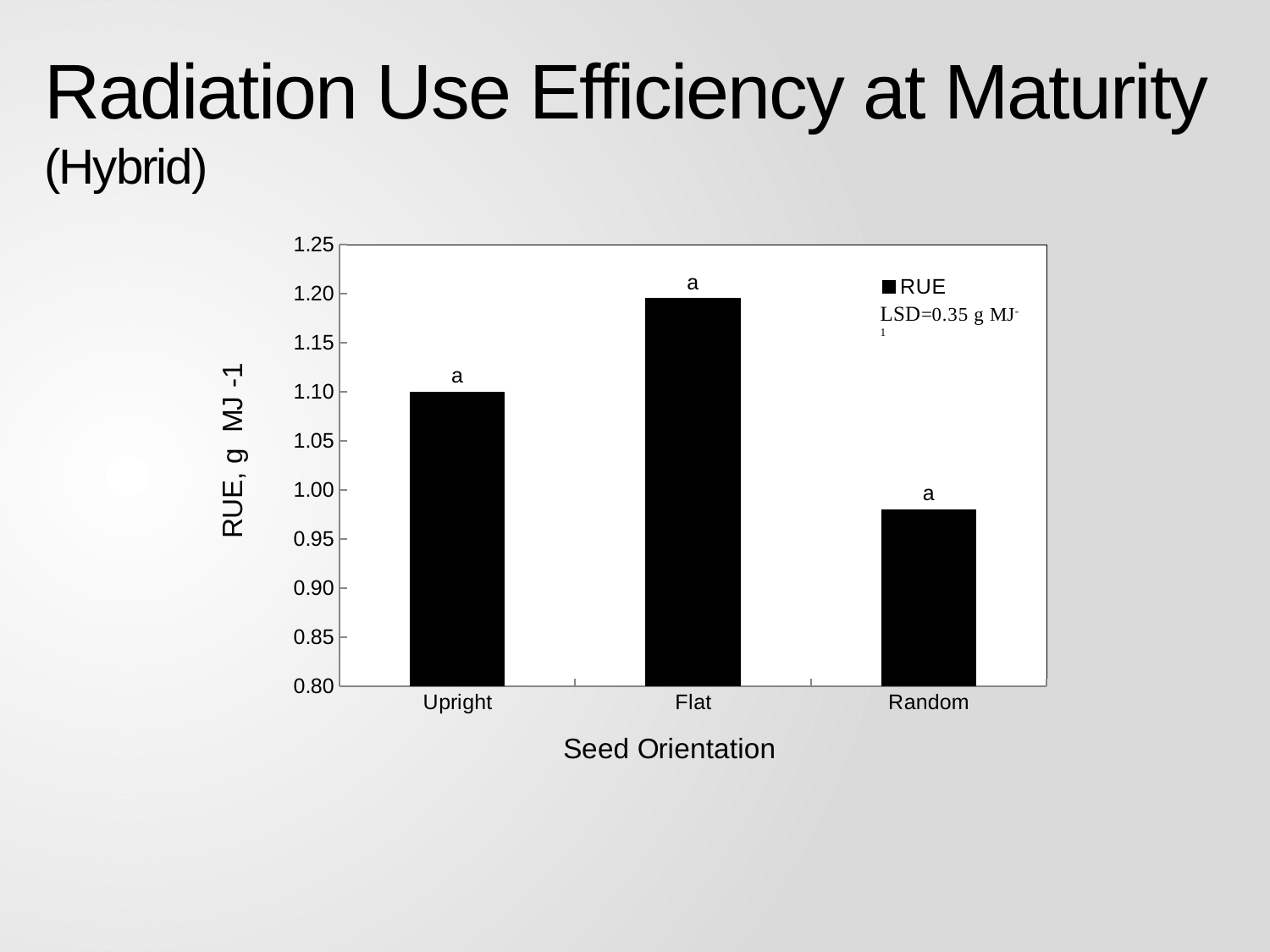
How many series does the chart legend list? 1 Which has a larger RUE value, Flat or Upright? Flat What is the label of the x axis of the chart? Seed Orientation Is the RUE value for Upright greater or less than 1.05? greater What kind of chart is shown on the slide? bar chart Which seed orientation has the highest RUE value? Flat How many seed orientation categories are plotted on the chart? 3 What series name is shown in the chart legend? RUE Which seed orientation has the lowest RUE value? Random Is the RUE value for Flat greater or less than 1.15? greater Is the RUE value for Random greater or less than 1.00? less Which has a larger RUE value, Upright or Random? Upright